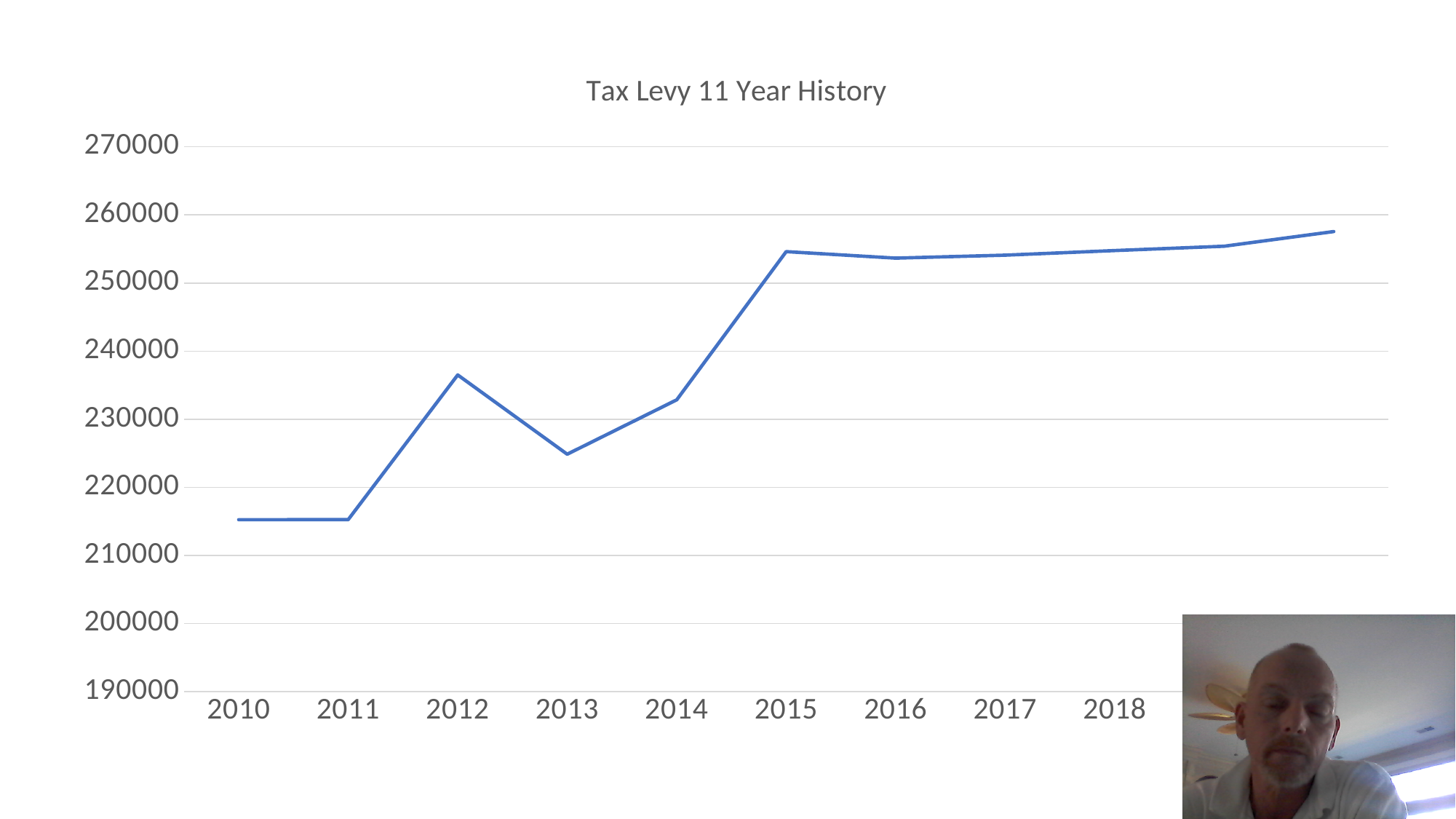
Which is larger, the value for 2014 or the value for 2015? 2015 Is the value for 2013 greater or less than 230000? less Is the value for 2010 greater or less than 220000? less Does the value rise or fall from 2012 to 2013? Fall What type of chart is shown on the slide? Line chart Among 2012, 2013 and 2014, which year has the lowest value? 2013 Overall, does the tax levy rise or fall from 2010 to 2018? Rise Is the value for 2016 greater or less than 250000? greater Which is larger, the value for 2012 or the value for 2013? 2012 What is the title of the chart? Tax Levy 11 Year History